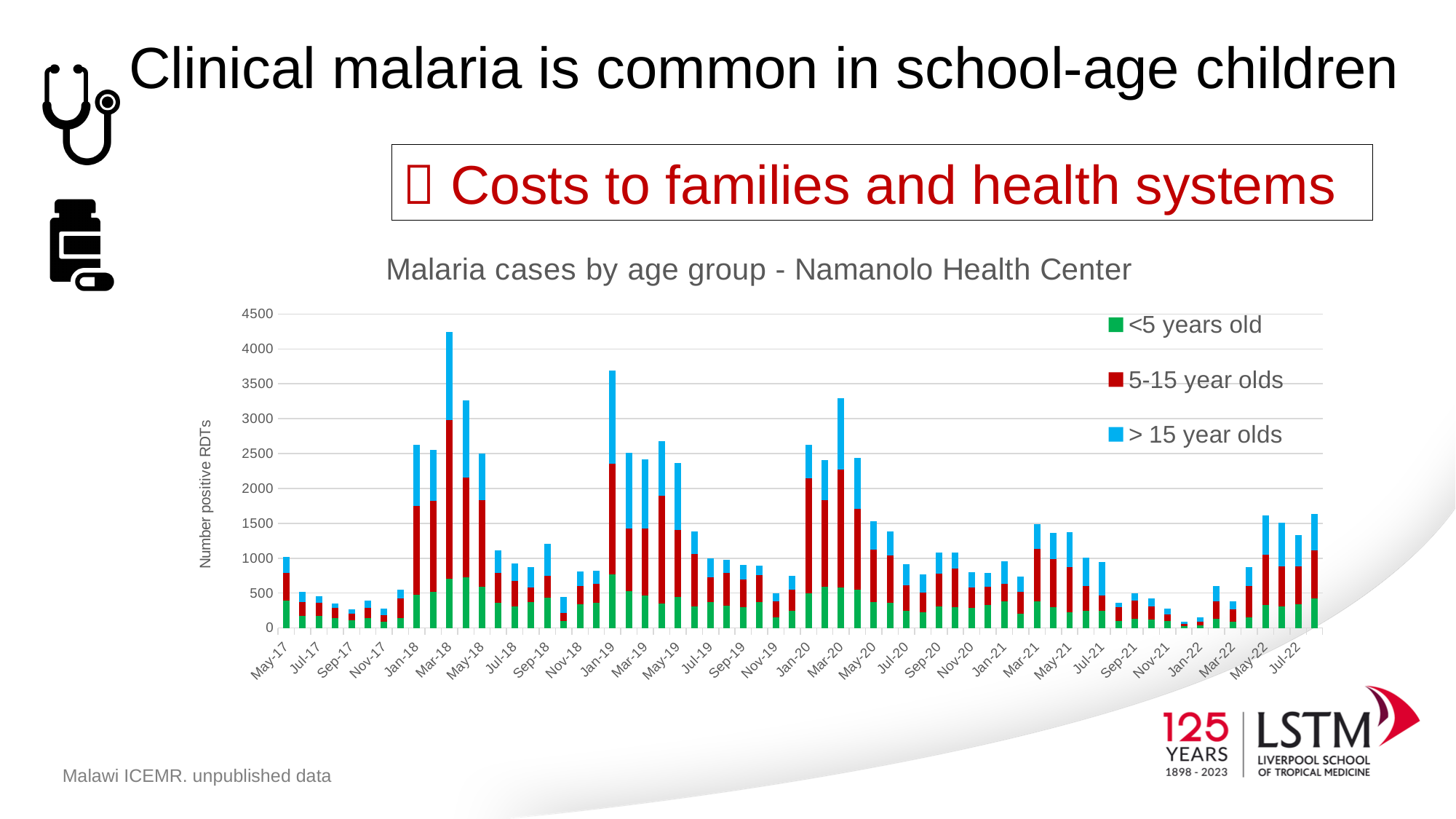
Which has a larger total number of positive RDTs, Mar-18 or Jan-19? Mar-18 Is the total value for Mar-20 greater or less than 3000? greater Is the total value for Jan-22 greater or less than 500? less Is the total value for Jan-19 greater or less than 3500? greater How many series does the chart legend list? 3 Which month has the highest total number of positive RDTs in the chart? Mar-18 Which age group is shown in red in the chart? 5-15 year olds What kind of chart is shown on the slide? Stacked bar chart What is the title of the chart? Malaria cases by age group - Namanolo Health Center What is the highest value shown on the y-axis of the chart? 4500